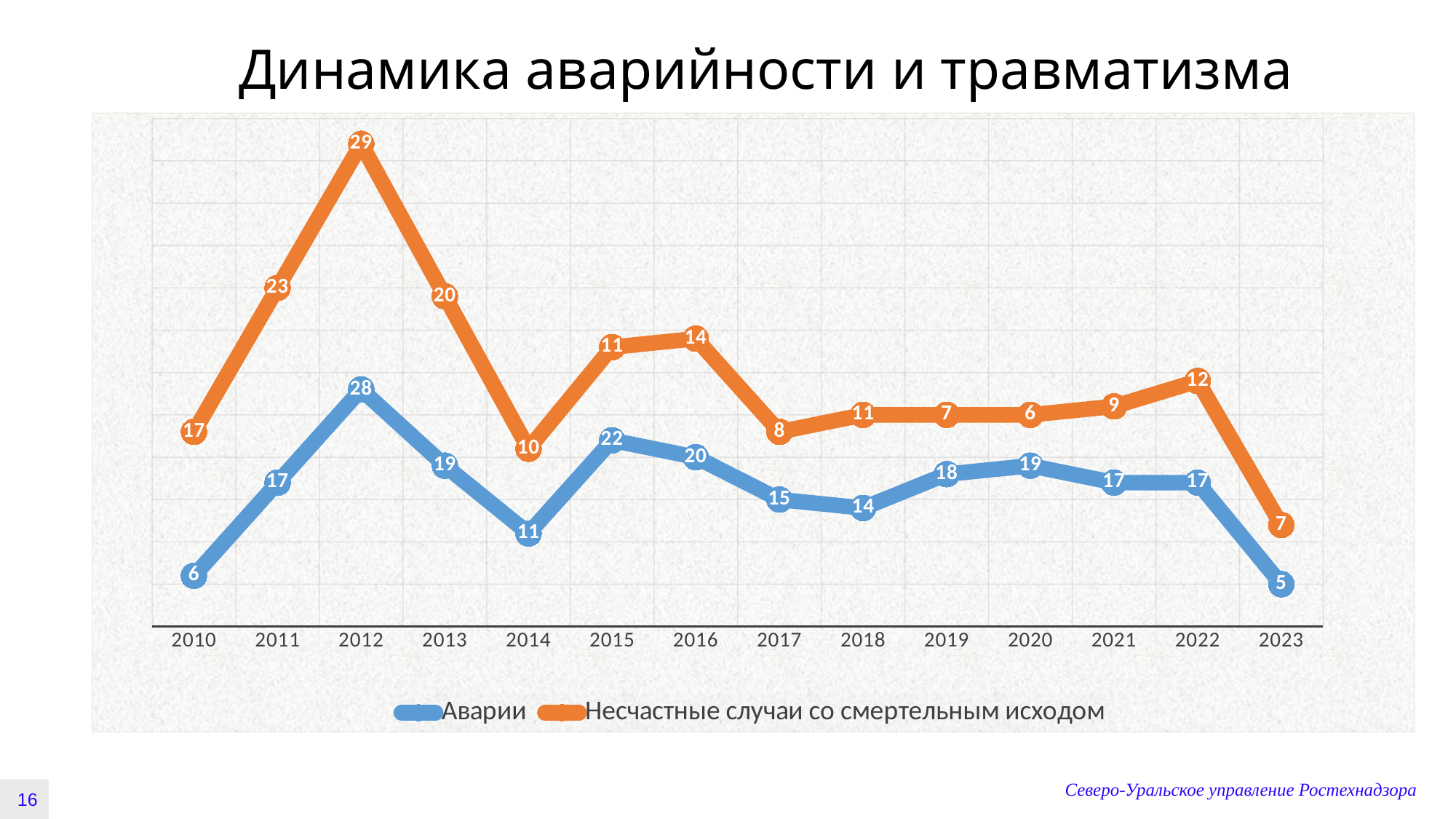
What is the value of Несчастные случаи со смертельным исходом in 2023? 7 What type of chart is shown on the slide? line chart Does the value of Несчастные случаи со смертельным исходом rise or fall from 2022 to 2023? fall Which is larger in 2020: the value of Аварии or the value of Несчастные случаи со смертельным исходом? Аварии In which year is the value of Аварии lowest? 2023 What is the value of Аварии in 2012? 28 What colour is the line for Аварии? blue How many years are shown on the x axis? 14 How many series does the legend list? 2 What is the title of the chart? Динамика аварийности и травматизма In which year is the value of Несчастные случаи со смертельным исходом highest? 2012 What is the difference between the Аварии values in 2012 and 2014? 17